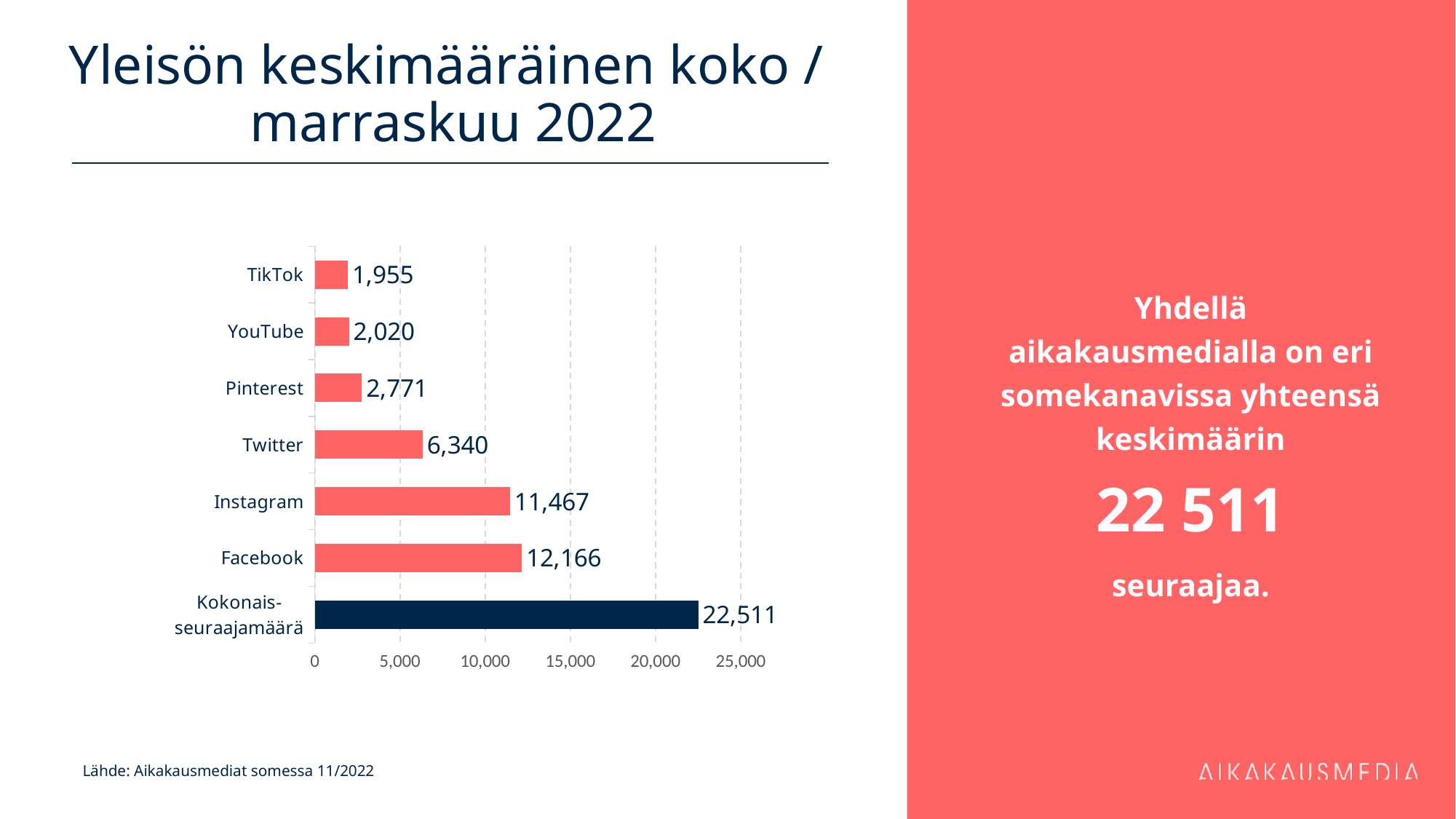
Is the value for Instagram greater or less than 10,000? greater How many categories are shown in the chart? 7 What kind of chart is shown on the slide? bar chart Which individual social media channel has the highest value? Facebook What is the difference between the values for Twitter and Pinterest? 3,569 Which category has the lowest value? TikTok What is the value for Kokonais-seuraajamäärä? 22,511 What is the value for Facebook? 12,166 What is the value for TikTok? 1,955 What is the difference between the values for Facebook and Instagram? 699 What is the value for Twitter? 6,340 Which is larger, the value for YouTube or the value for Pinterest? Pinterest